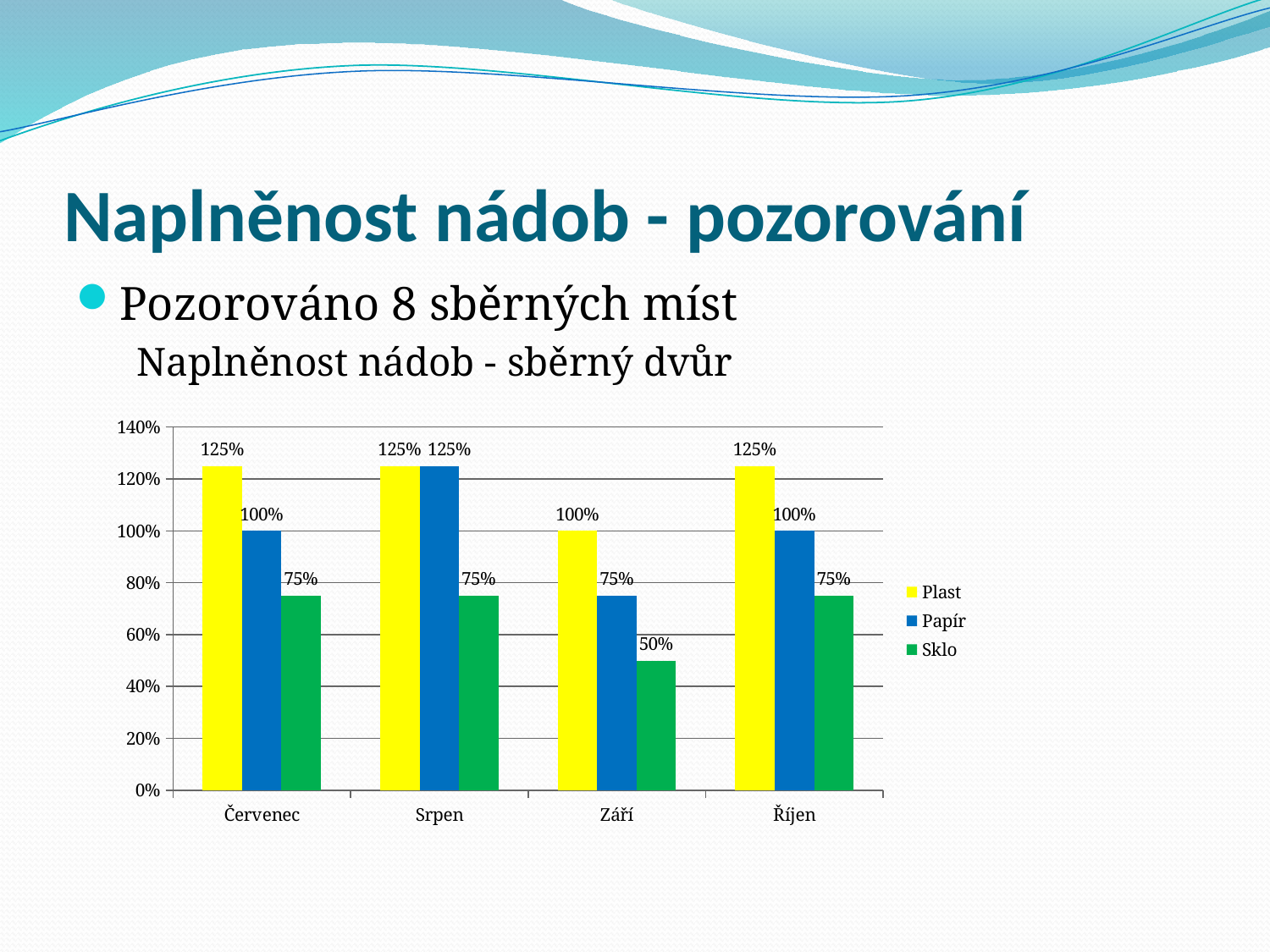
What is the value for Sklo in Září? 50% What is the value for Papír in Září? 75% What kind of chart is shown on the slide? Bar chart How many series does the legend list? 3 What is the title of the chart? Naplněnost nádob - sběrný dvůr Which month has the lowest value for Sklo? Září What is the value for Plast in Červenec? 125% What is the difference between Plast and Sklo in Říjen? 50% What is the value for Papír in Srpen? 125% How many months are shown on the x axis? 4 Which is larger in Září: Papír or Sklo? Papír Which month has the lowest value for Plast? Září